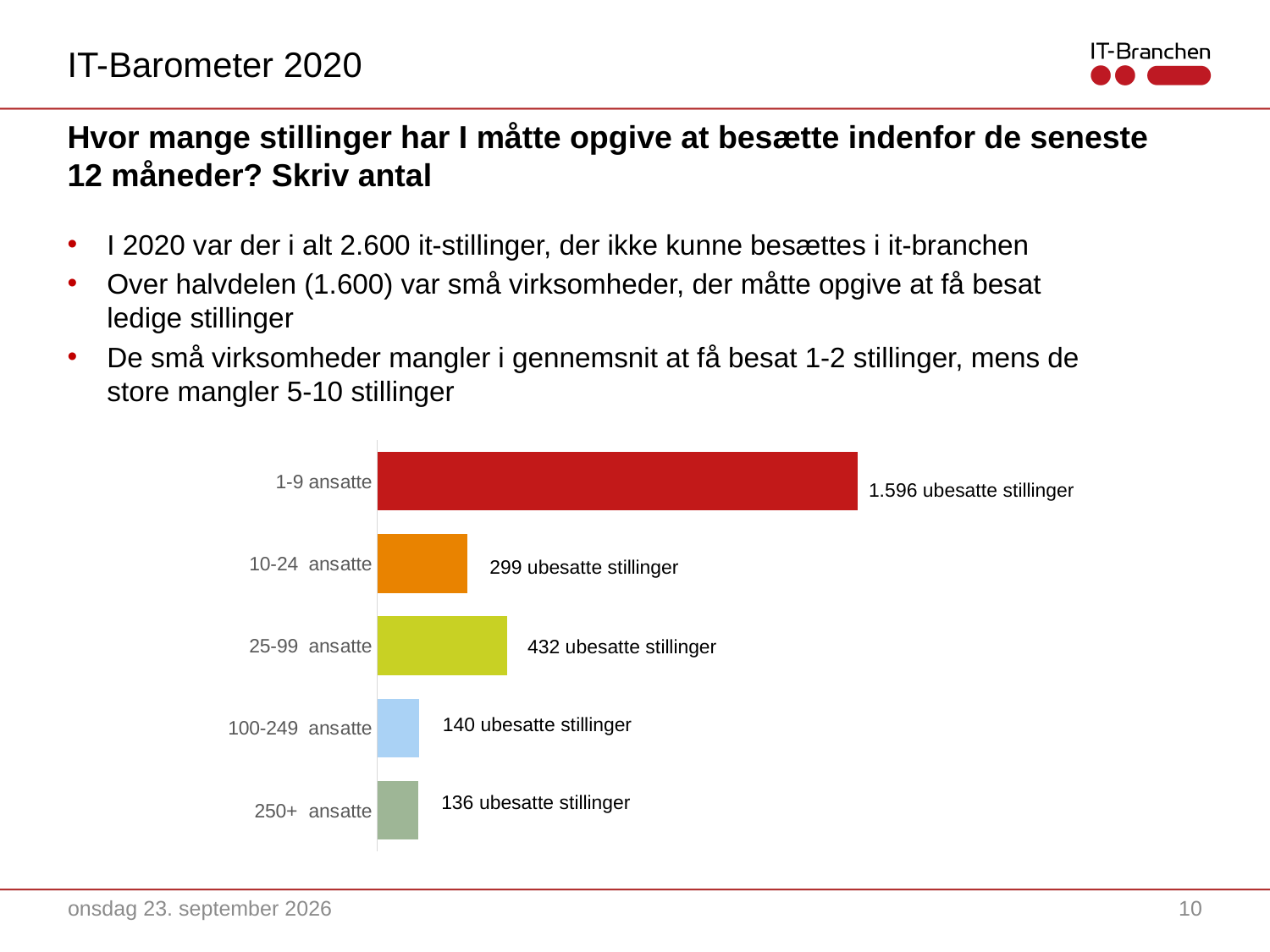
What colour is the bar for the 1-9 ansatte category? Red What is the value shown for the 25-99 ansatte category? 432 ubesatte stillinger What is the value shown for the 10-24 ansatte category? 299 ubesatte stillinger How many unfilled positions (ubesatte stillinger) are shown for companies with 1-9 ansatte? 1.596 ubesatte stillinger What is the difference between the unfilled positions for 25-99 ansatte and 10-24 ansatte? 133 What type of chart is shown on the slide? Bar chart Which company size category has the highest number of unfilled positions? 1-9 ansatte What is the difference between the unfilled positions for 1-9 ansatte and 10-24 ansatte? 1.297 Which company size category has the lowest number of unfilled positions? 250+ ansatte How many company size categories are shown in the chart? 5 What is the value shown for the 250+ ansatte category? 136 ubesatte stillinger Which has more unfilled positions: 25-99 ansatte or 10-24 ansatte? 25-99 ansatte